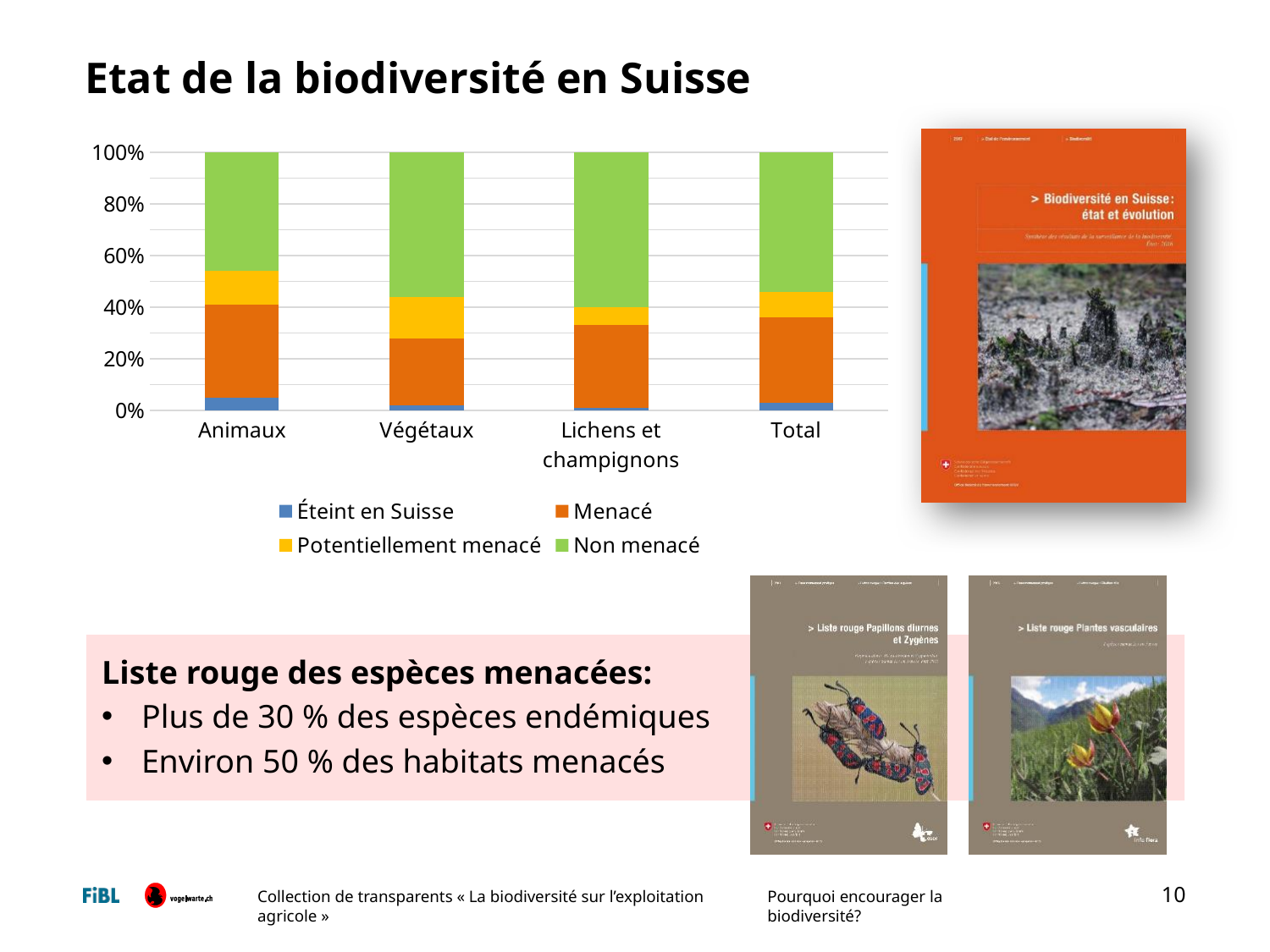
Is the 'Non menacé' share for Lichens et champignons greater or less than 40%? greater Which category has the smallest 'Potentiellement menacé' share? Lichens et champignons How many categories are shown on the x axis of the chart? 4 What kind of chart is shown on the slide? Stacked bar chart Is the 'Menacé' share for Végétaux greater or less than 40%? less Which category has the smallest 'Non menacé' share? Animaux How many series does the chart legend list? 4 Which category has the largest 'Éteint en Suisse' share? Animaux What is the title of the slide containing the chart? Etat de la biodiversité en Suisse Which colour represents the 'Non menacé' series in the chart? Green Is the 'Non menacé' share for Animaux greater or less than 60%? less Is the 'Éteint en Suisse' share for Animaux larger or smaller than that for Végétaux? larger